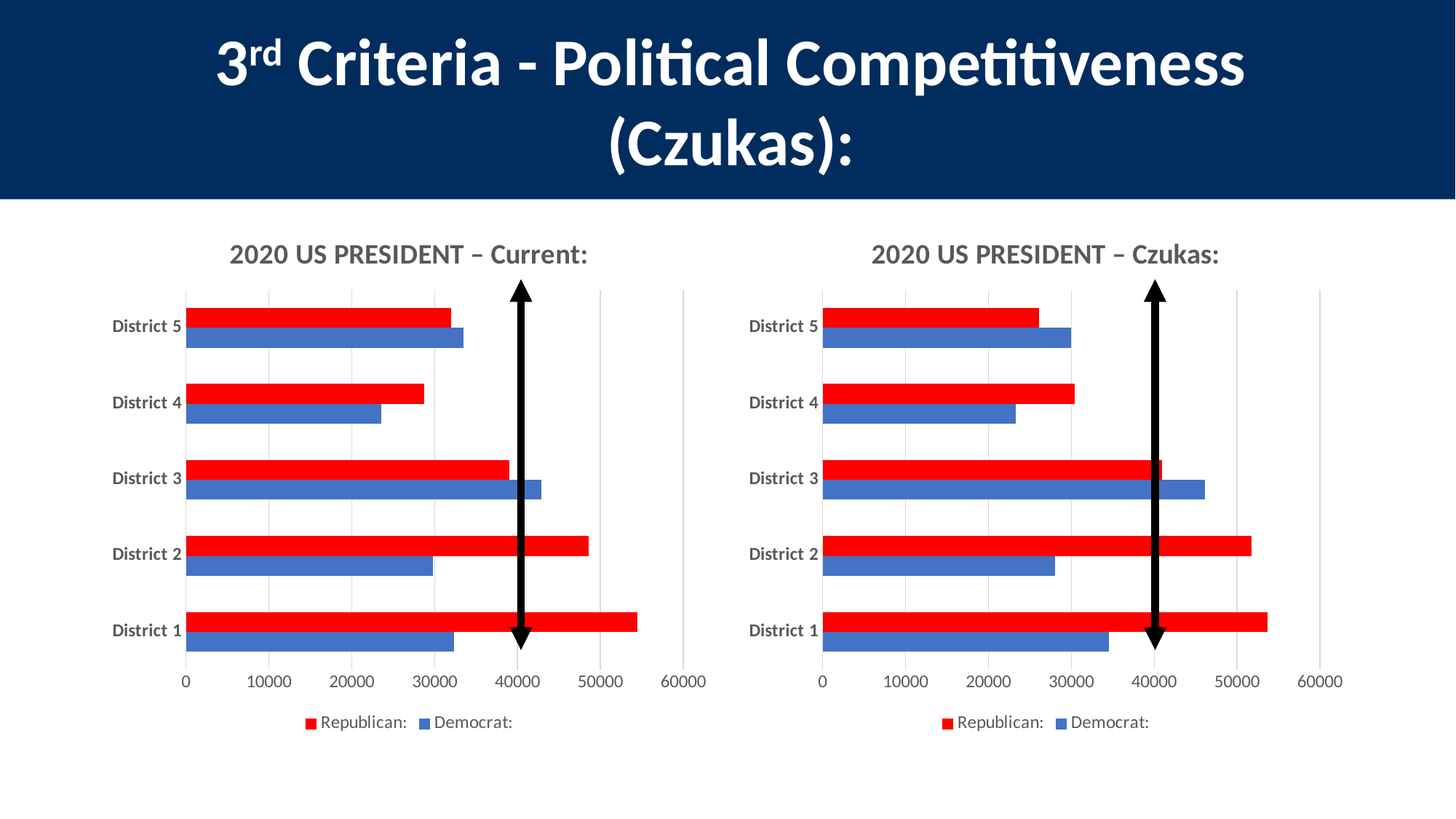
In the "2020 US PRESIDENT – Czukas:" chart, which district has the highest Democrat value? District 3 What kind of chart is the "2020 US PRESIDENT – Current:" chart? bar chart How many districts are shown on the "2020 US PRESIDENT – Czukas:" chart? 5 What are the two legend entries on the "2020 US PRESIDENT – Czukas:" chart? Republican and Democrat How many series does the legend of the "2020 US PRESIDENT – Current:" chart list? 2 In the "2020 US PRESIDENT – Current:" chart, which district has the lowest Democrat value? District 4 In the "2020 US PRESIDENT – Czukas:" chart, is the Republican value for District 5 greater or less than 30000? less In the "2020 US PRESIDENT – Czukas:" chart, for District 4, which is larger: the Republican or the Democrat value? Republican In the "2020 US PRESIDENT – Current:" chart, is the Republican value for District 1 greater or less than 50000? greater In the "2020 US PRESIDENT – Current:" chart, which district has the highest Republican value? District 1 In the "2020 US PRESIDENT – Current:" chart, for District 3, which is larger: the Republican or the Democrat value? Democrat In the "2020 US PRESIDENT – Current:" chart, is the Democrat value for District 2 greater or less than 40000? less